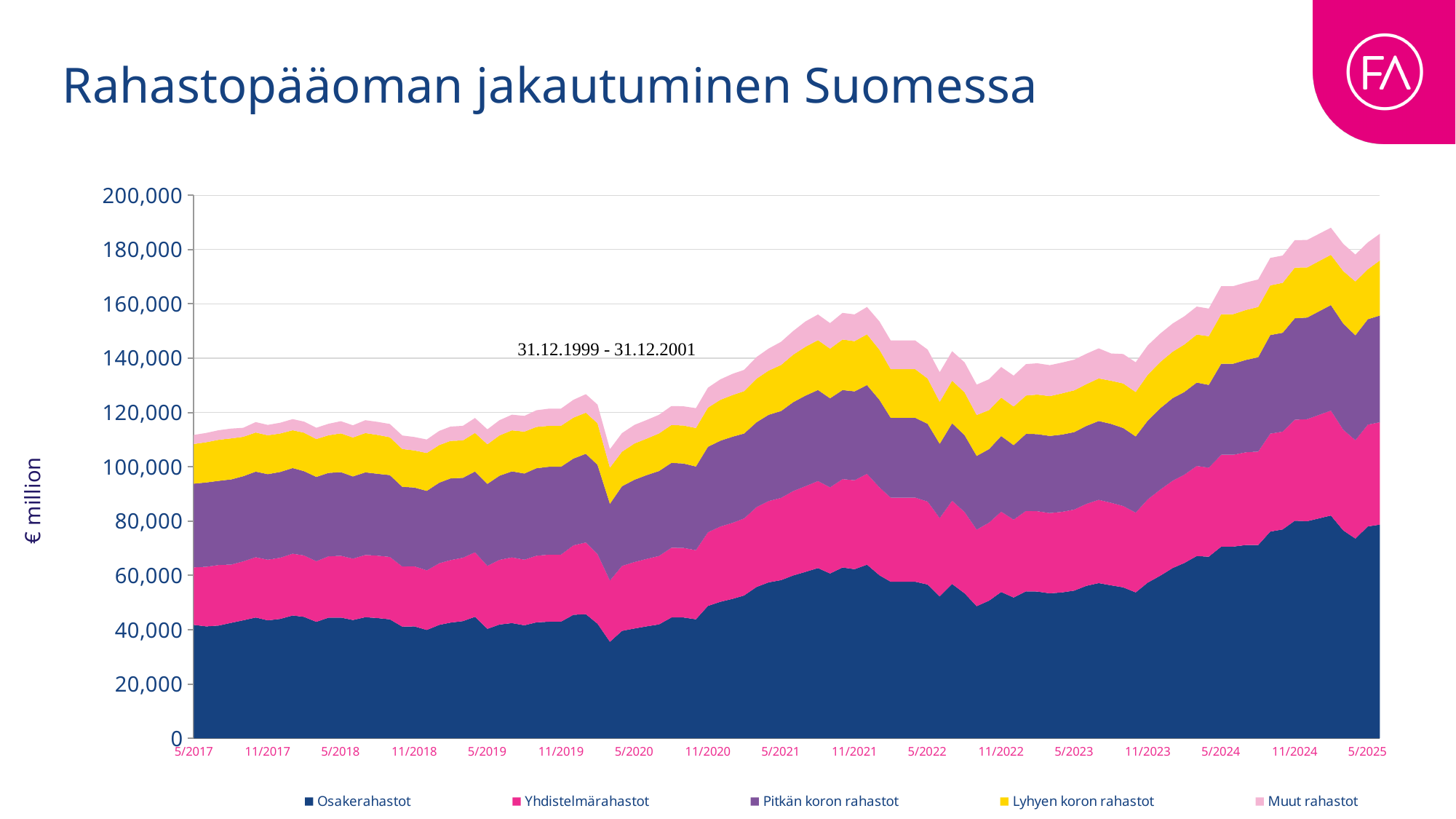
What kind of chart is shown on the slide? Stacked area chart Is the value for Osakerahastot at 5/2017 greater or less than 60,000? less What unit is shown on the vertical axis label? € million Is the total stacked value at 5/2017 greater or less than 120,000? less Is the value for Osakerahastot at 5/2025 greater or less than 60,000? greater How many series does the legend list? 5 Does the total fund capital rise or fall overall from 5/2017 to 5/2025? rise Which is larger, the total stacked value at 5/2017 or at 5/2025? 5/2025 How many date labels are shown on the x axis? 17 What is the title of the chart? Rahastopääoman jakautuminen Suomessa